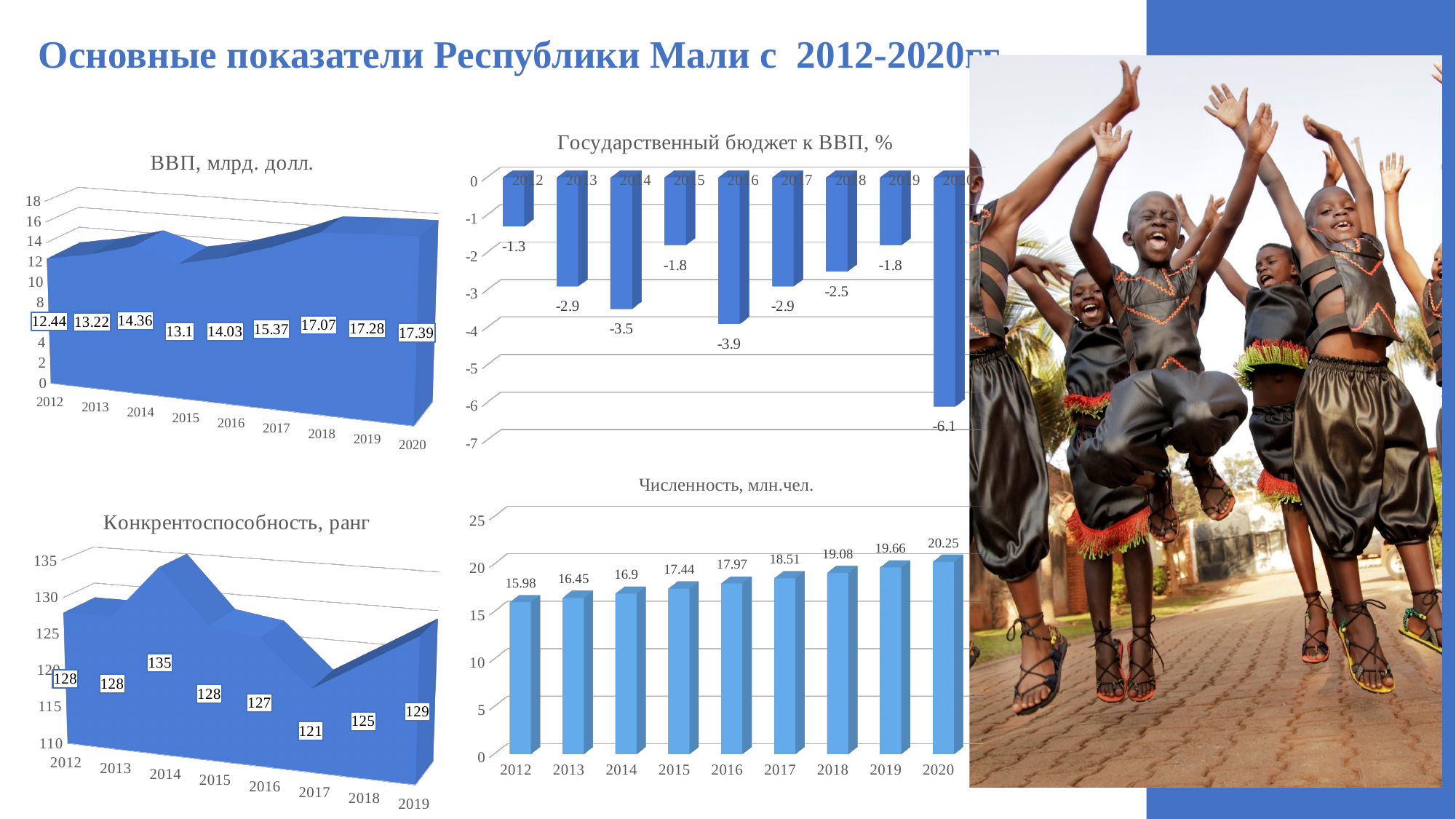
In the chart titled "Численность, млн.чел.", what is the value for 2015? 17.44 In the chart titled "ВВП, млрд. долл.", which year has the lowest value? 2012 In the chart titled "Конкрентоспособность, ранг", what is the value for 2017? 121 In the chart titled "Государственный бюджет к ВВП, %", what is the value for 2016? -3.9 In the chart titled "Конкрентоспособность, ранг", how many years are plotted? 8 In the chart titled "Численность, млн.чел.", do the values rise or fall from 2012 to 2020? rise What kind of chart is the one titled "Численность, млн.чел."? bar chart In the chart titled "ВВП, млрд. долл.", what is the value for 2020? 17.39 In the chart titled "ВВП, млрд. долл.", what is the difference between the 2018 value and the 2015 value? 3.97 In the chart titled "Государственный бюджет к ВВП, %", how many years are plotted? 9 In the chart titled "Государственный бюджет к ВВП, %", which year has the lowest (most negative) value? 2020 In the chart titled "Конкрентоспособность, ранг", which year has the highest value? 2014